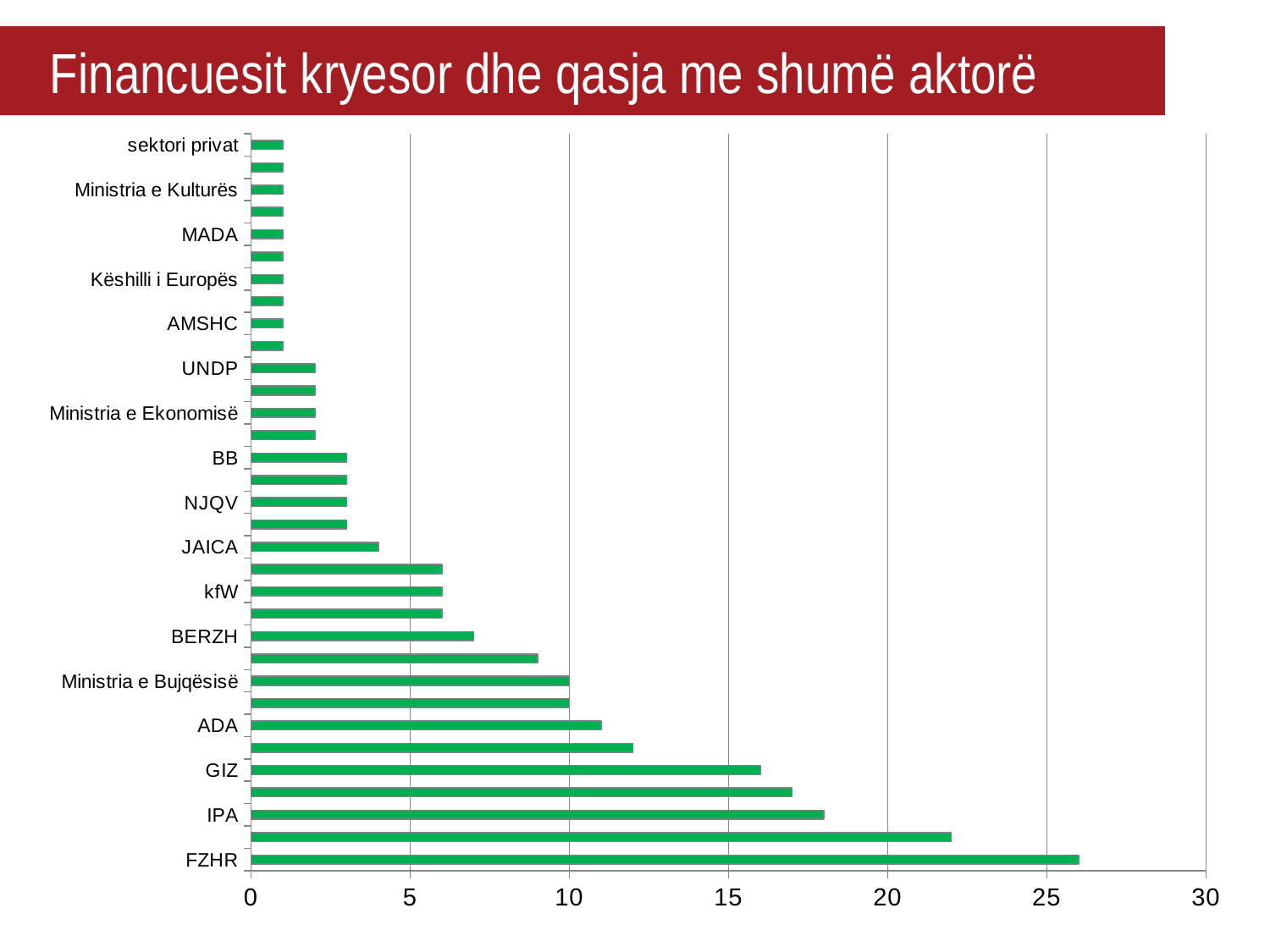
Is the value for ADA greater or less than 10? greater Which category has the highest value? FZHR Is the value for GIZ greater or less than 15? greater Is the value for FZHR greater or less than 25? greater What kind of chart is shown on the slide? bar chart Which is larger, the value for FZHR or the value for IPA? FZHR What is the title of the slide containing the chart? Financuesit kryesor dhe qasja me shumë aktorë What is the maximum value shown on the horizontal axis? 30 Which is larger, the value for GIZ or the value for ADA? GIZ